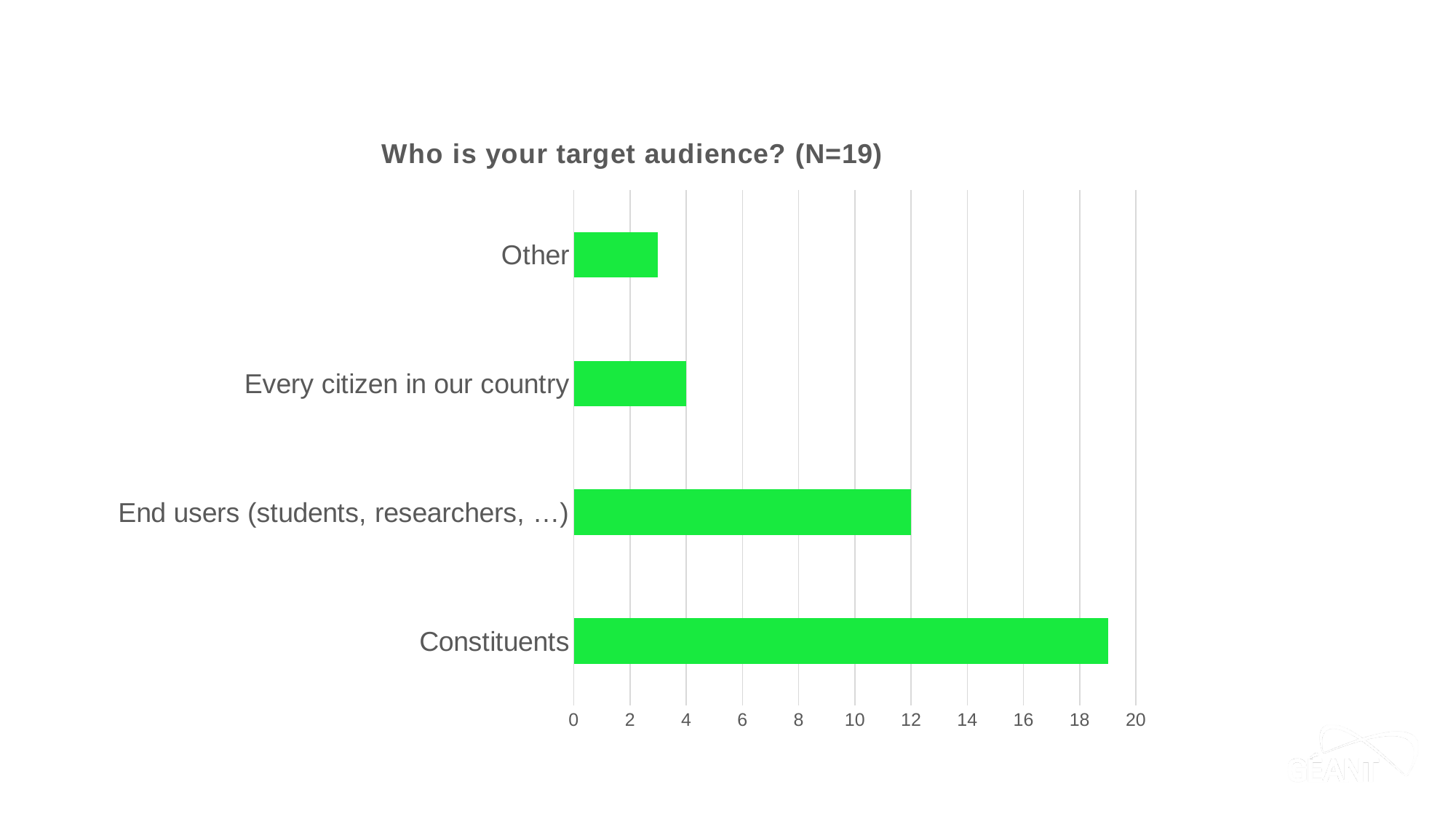
Is the value for "Other" greater or less than 4? less How many categories are shown in the chart? 4 Which is larger, the value for "Other" or the value for "Every citizen in our country"? Every citizen in our country What is the difference between the values for "End users (students, researchers, …)" and "Every citizen in our country"? 8 Which category has the highest value? Constituents What kind of chart is shown on the slide? bar chart What is the title of the chart? Who is your target audience? (N=19) What colour are the bars in the chart? green Is the value for "Constituents" greater or less than 18? greater What is the value for "End users (students, researchers, …)"? 12 Which category has the lowest value? Other What is the value for "Every citizen in our country"? 4